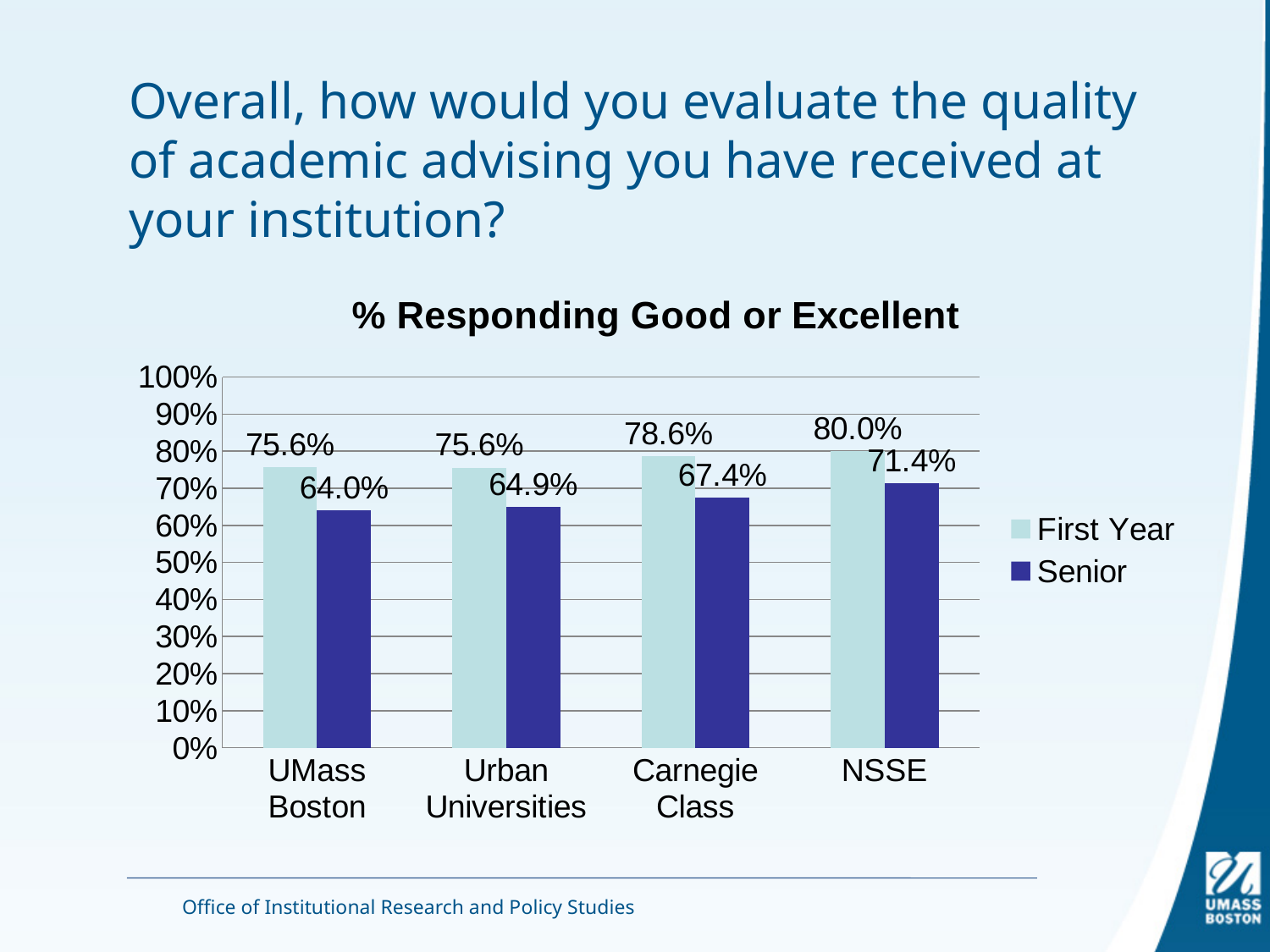
What is the difference between the NSSE and UMass Boston First Year values? 4.4% Which is larger, the Senior value for Urban Universities or the Senior value for Carnegie Class? Carnegie Class What is the difference between the First Year and Senior values for UMass Boston? 11.6% Which category has the highest First Year value? NSSE How many series does the legend list? 2 What is the Senior value for Carnegie Class? 67.4% What is the title of the chart? % Responding Good or Excellent What is the Senior value for NSSE? 71.4% How many categories are shown on the x axis? 4 Which category has the lowest Senior value? UMass Boston What kind of chart is shown? Bar chart What is the First Year value for UMass Boston? 75.6%